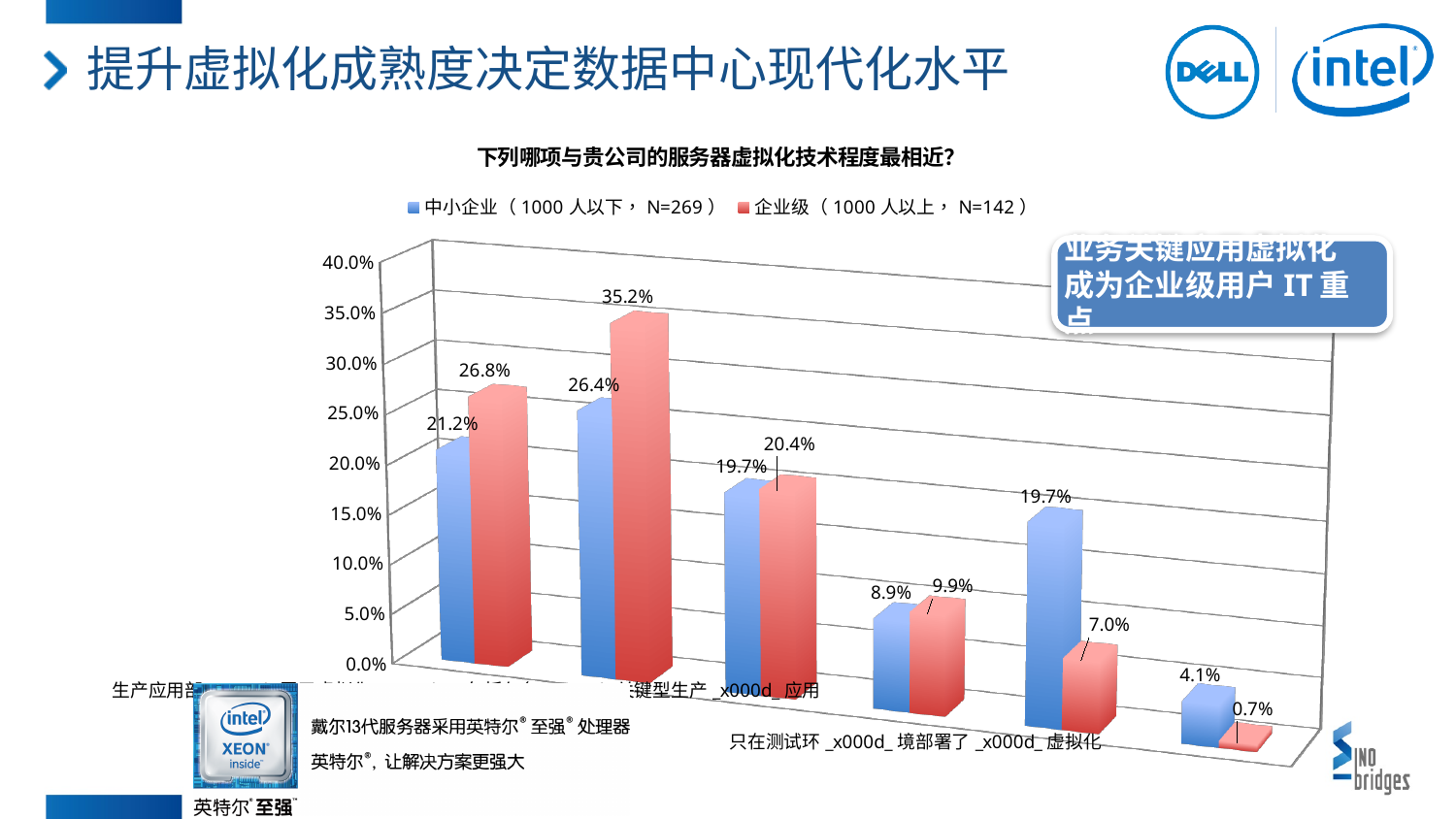
Which group from the left has the highest 企业级 (red) value? The second group (35.2%) What type of chart is shown on the slide? Bar chart What is the sample size (N) given in the legend for the 企业级 series? N=142 What is the difference between the 企业级 and 中小企业 values in the second group from the left? 8.8 percentage points Is the 中小企业 value in the fourth group from the left greater or less than 10.0%? less What is the value of the 企业级 (red) bar in the second group from the left? 35.2% What is the value of the 企业级 (red) bar in the rightmost group? 0.7% How many category groups of bars are plotted in the chart? 6 Which group has the lowest 中小企业 (blue) value? The rightmost group (4.1%) What is the value of the 中小企业 (blue) bar in the first group from the left? 21.2% How many series does the chart legend list? 2 In the fifth group from the left, which series has the larger value, 中小企业 or 企业级? 中小企业